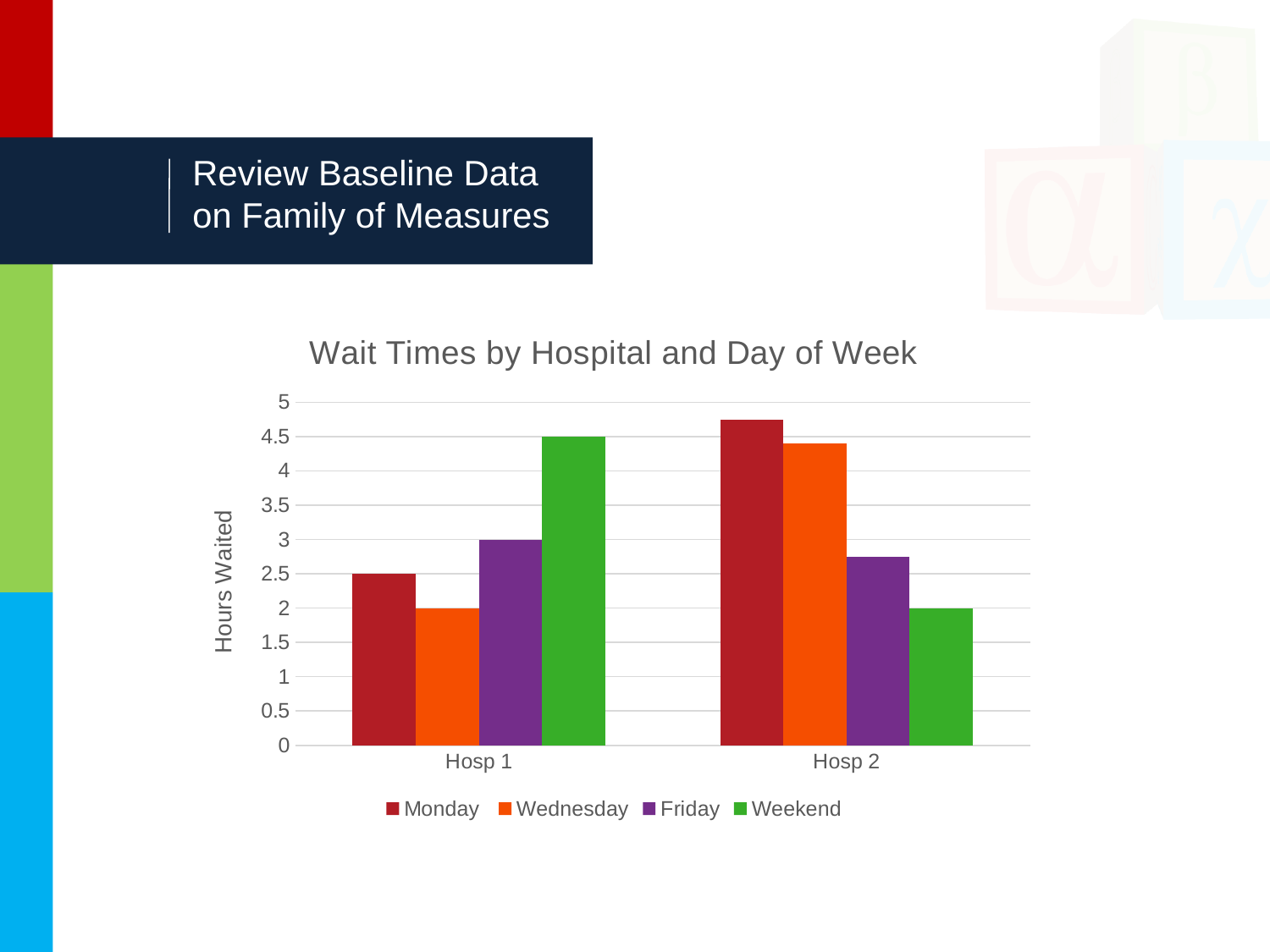
What type of chart is shown on the slide? Bar chart What is the difference between the Weekend and Wednesday wait times for Hosp 1? 2.5 What is the Weekend wait time for Hosp 2? 2 How many series does the legend list in the Wait Times by Hospital and Day of Week chart? 4 For Hosp 2, which day has the lowest wait time? Weekend Is the Monday wait time for Hosp 2 greater or less than 4.5? greater How many hospitals are shown on the x axis of the chart? 2 For Hosp 1, which day has the highest wait time? Weekend What is the Weekend wait time for Hosp 1? 4.5 What is the Monday wait time for Hosp 1? 2.5 Which hospital has the larger Monday wait time, Hosp 1 or Hosp 2? Hosp 2 What is the label on the vertical axis of the chart? Hours Waited